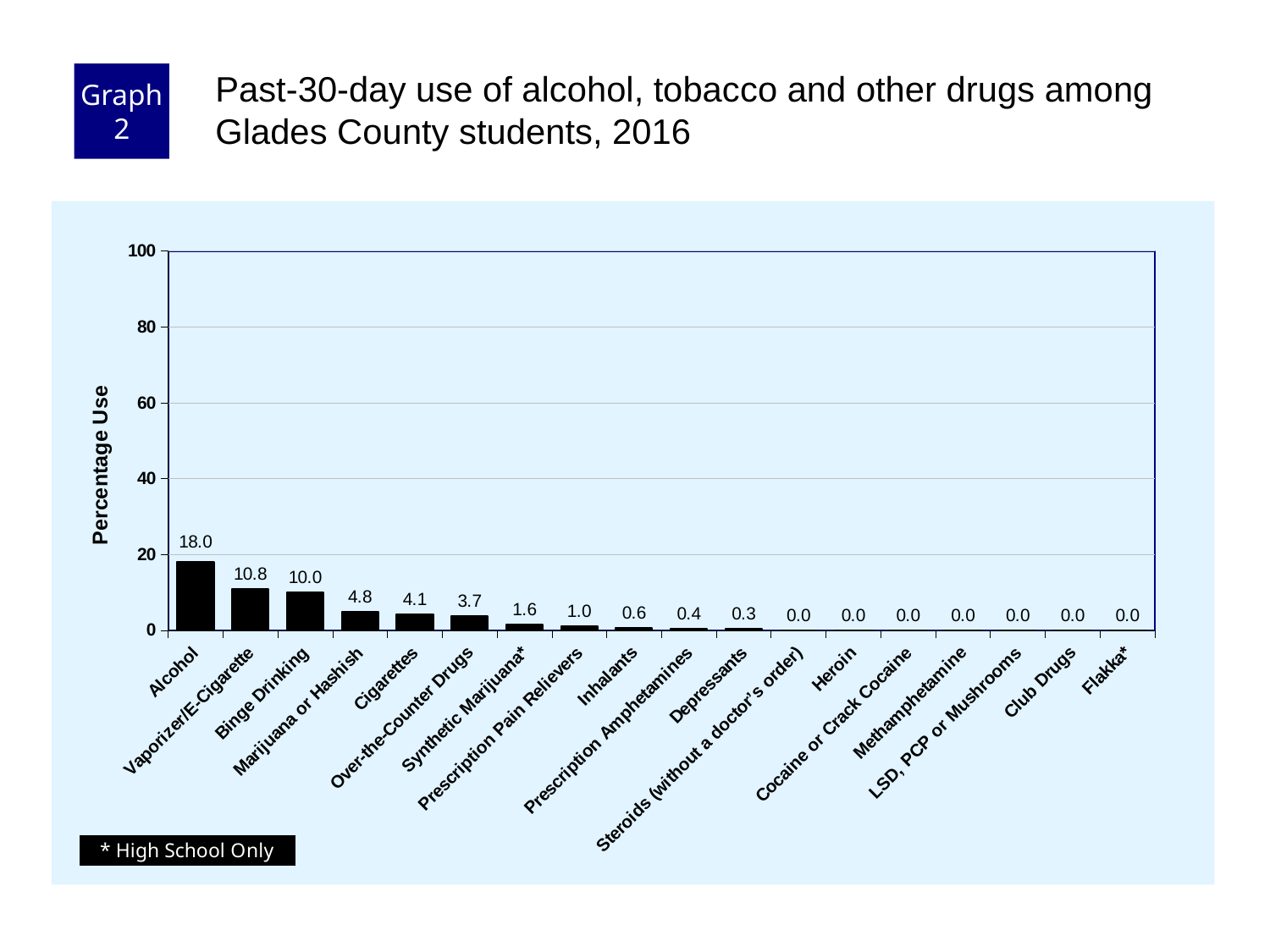
What is the difference in percentage use between Alcohol and Binge Drinking? 8.0 Do the values rise or fall moving from left to right along the x axis? Fall How many categories are shown on the x axis? 18 Is the value for Alcohol greater or less than 20? less What is the percentage use for Alcohol? 18.0 Which category has the highest percentage use? Alcohol What kind of chart is shown on the slide? Bar chart What is the percentage use for Cigarettes? 4.1 What is the percentage use for Vaporizer/E-Cigarette? 10.8 What is the percentage use for Synthetic Marijuana*? 1.6 What is the label of the y axis? Percentage Use Which has a higher percentage use, Marijuana or Hashish or Over-the-Counter Drugs? Marijuana or Hashish